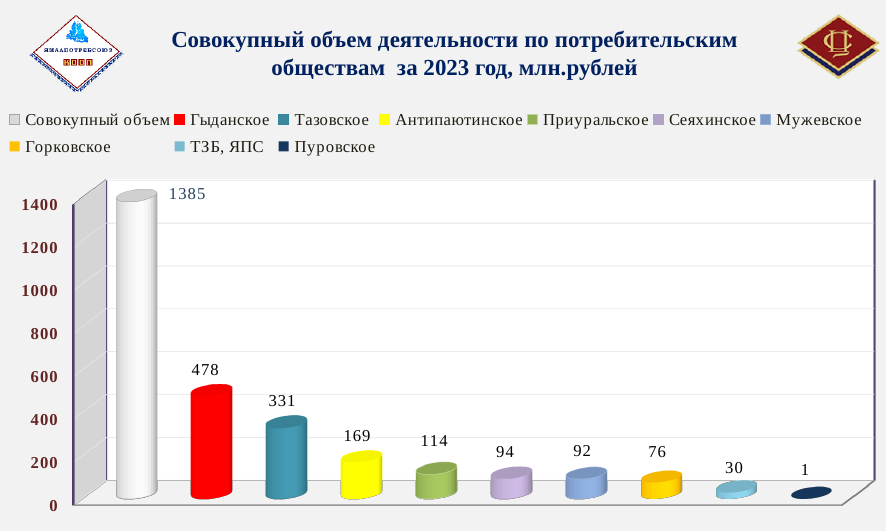
What is the value for Тазовское? 331 Which series has the highest value? Совокупный объем Which series has the lowest value? Пуровское How many series does the legend list? 10 What is the value for Совокупный объем? 1385 What is the difference between the values for Горковское and ТЗБ, ЯПС? 46 What kind of chart is shown on the slide? Bar chart Which is larger, the value for Антипаютинское or the value for Приуральское? Антипаютинское What is the value for Гыданское? 478 What colour is the bar for Гыданское? Red What is the value for Пуровское? 1 What is the difference between the values for Гыданское and Тазовское? 147